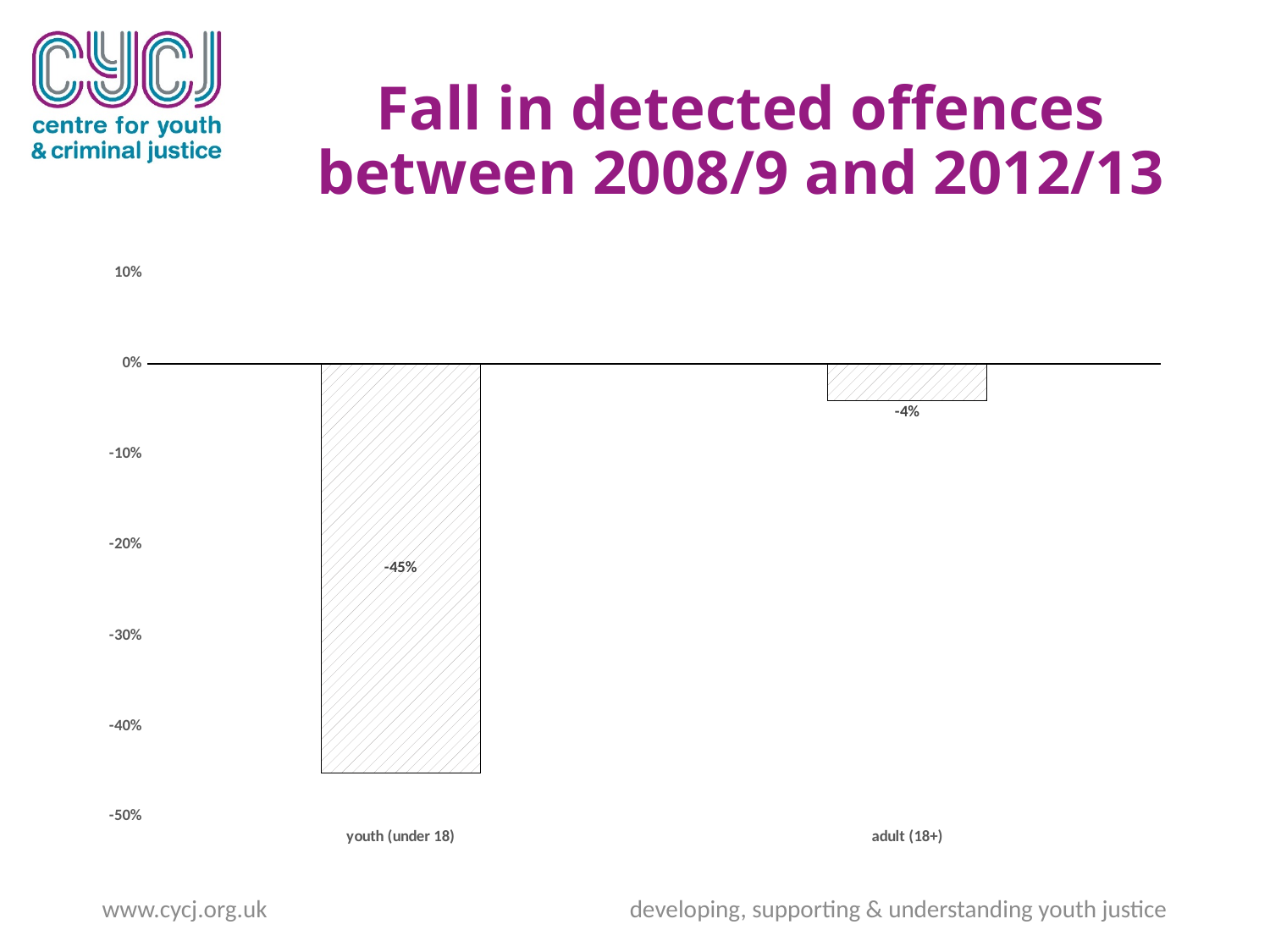
Is the value for adult (18+) greater or less than -10%? greater What kind of chart is shown on the slide? bar chart Which category shows the smaller fall in detected offences? adult (18+) Is the value for youth (under 18) greater or less than -40%? less Is the fall for youth (under 18) larger or smaller than the fall for adult (18+)? larger What is the difference in percentage points between the youth (under 18) and adult (18+) values? 41 percentage points What is the value for adult (18+)? -4% What is the value for youth (under 18)? -45% How many categories are shown on the chart? 2 What is the title of the slide? Fall in detected offences between 2008/9 and 2012/13 Which category shows the larger fall in detected offences? youth (under 18) What is the lowest value shown on the vertical axis? -50%